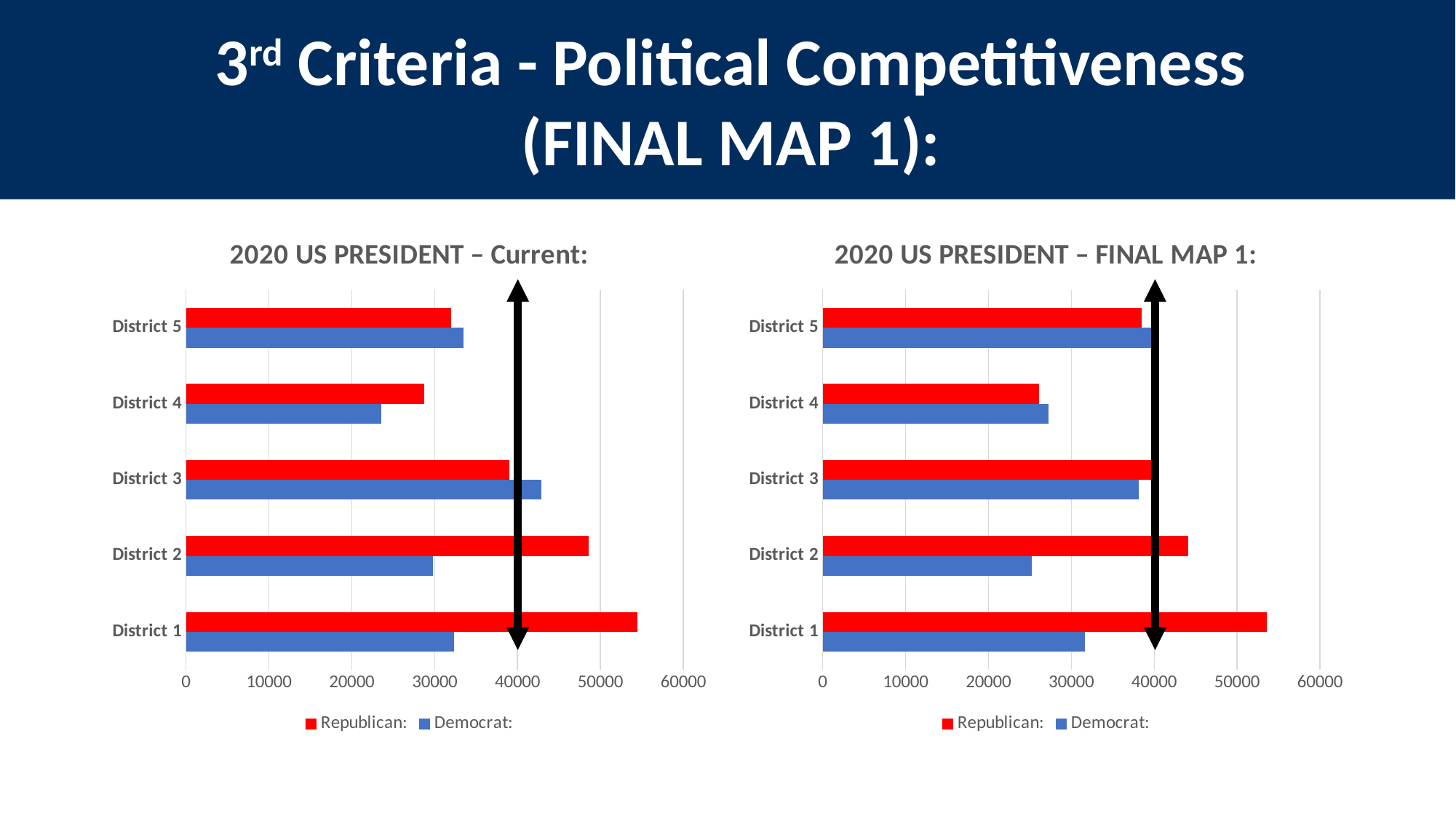
On the '2020 US PRESIDENT – Current:' chart, which district has the lowest Democrat value? District 4 On the '2020 US PRESIDENT – Current:' chart, is the Republican or Democrat value larger for District 2? Republican What are the two legend entries on the '2020 US PRESIDENT – Current:' chart? Republican and Democrat On the '2020 US PRESIDENT – FINAL MAP 1:' chart, which district has the highest Republican value? District 1 On the '2020 US PRESIDENT – FINAL MAP 1:' chart, is the Democrat value for District 4 greater or less than 30000? less On the '2020 US PRESIDENT – FINAL MAP 1:' chart, which district has the lowest Republican value? District 4 On the '2020 US PRESIDENT – Current:' chart, is the Republican value for District 1 greater or less than 50000? greater On the '2020 US PRESIDENT – FINAL MAP 1:' chart, is the Republican or Democrat value larger for District 2? Republican How many series does the legend of the '2020 US PRESIDENT – FINAL MAP 1:' chart list? 2 What kind of chart is the '2020 US PRESIDENT – Current:' chart? Bar chart How many districts are shown on the '2020 US PRESIDENT – Current:' chart? 5 On the '2020 US PRESIDENT – Current:' chart, which district has the highest Republican value? District 1